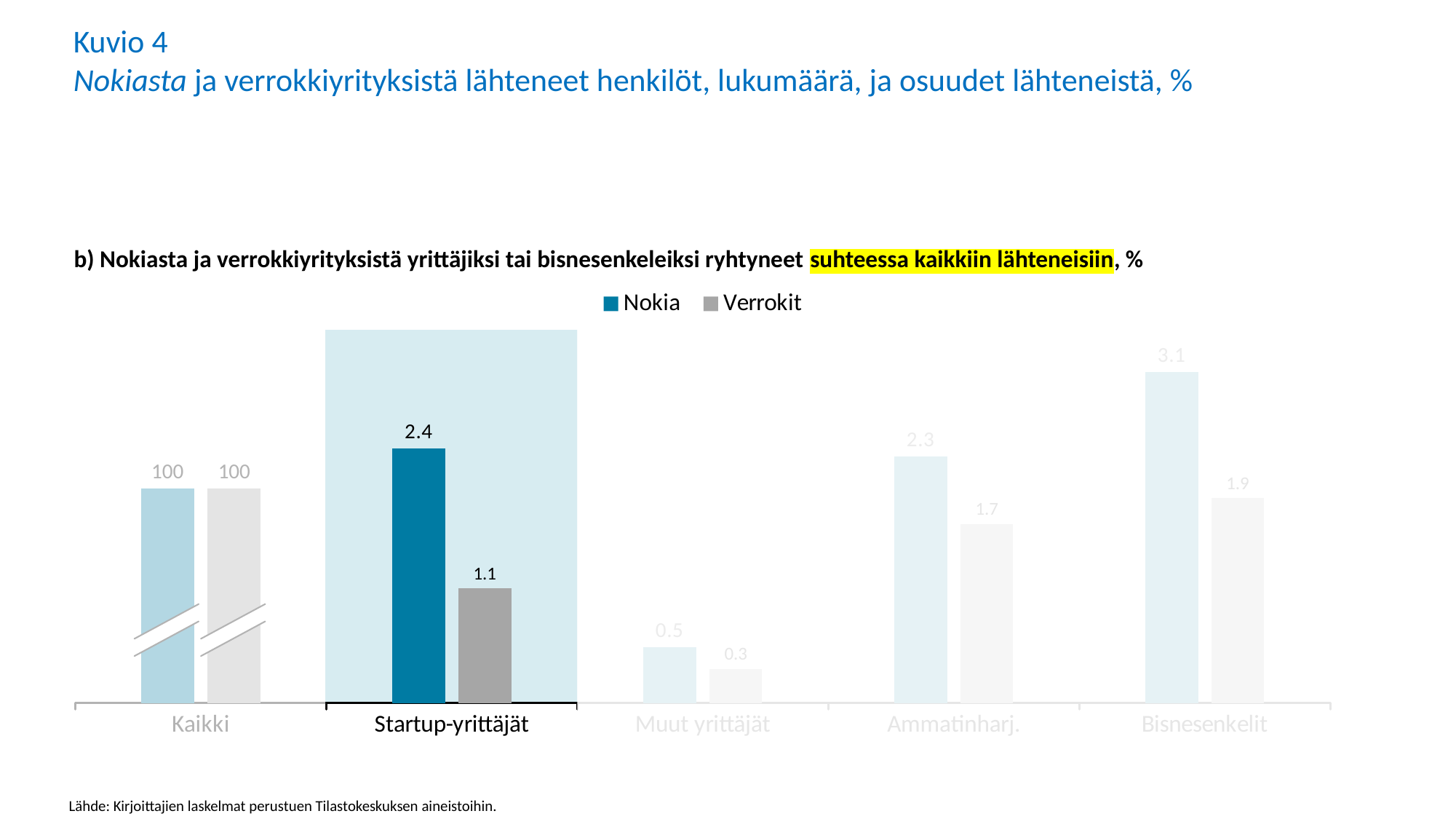
Excluding Kaikki, which category has the highest Nokia value? Bisnesenkelit What is the Nokia value for Startup-yrittäjät? 2.4 How many series does the legend list? 2 What is the difference between the Nokia and Verrokit values for Startup-yrittäjät? 1.3 What is the Verrokit value for Ammatinharj.? 1.7 What is the Verrokit value for Startup-yrittäjät? 1.1 What kind of chart is shown on the slide? Bar chart What is the Nokia value for Bisnesenkelit? 3.1 Which is larger, the Nokia value for Ammatinharj. or the Nokia value for Startup-yrittäjät? Startup-yrittäjät What is the difference between the Nokia and Verrokit values for Bisnesenkelit? 1.2 Which category has the lowest Verrokit value? Muut yrittäjät How many categories are shown on the x axis? 5